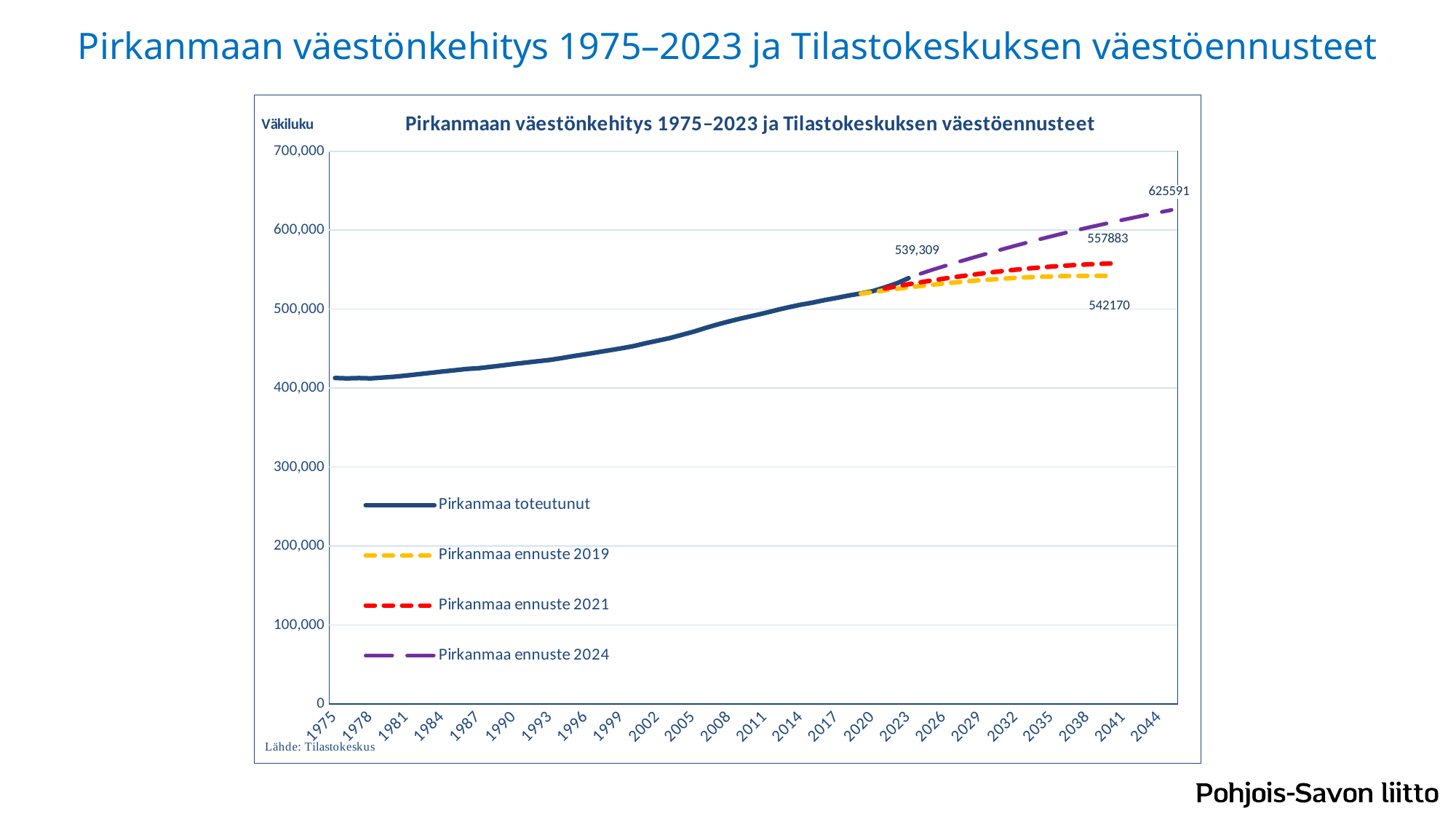
What is the difference between the labelled end values of Pirkanmaa ennuste 2021 and Pirkanmaa ennuste 2019? 15713 What is the labelled end value of the Pirkanmaa ennuste 2019 series? 542170 Does the Pirkanmaa toteutunut series rise or fall from 1975 to 2023? rise What is the difference between the labelled end values of Pirkanmaa ennuste 2024 and Pirkanmaa ennuste 2021? 67708 What is the labelled end value of the Pirkanmaa ennuste 2024 series? 625591 What is the labelled end value of the Pirkanmaa ennuste 2021 series? 557883 What kind of chart is shown on the slide? line chart How many series does the legend list? 4 Which forecast series ends at the highest labelled value? Pirkanmaa ennuste 2024 Is the value of Pirkanmaa toteutunut in 1975 greater or less than 400,000? greater What is the labelled latest value of the Pirkanmaa toteutunut series? 539,309 Which forecast series ends at the lowest labelled value? Pirkanmaa ennuste 2019